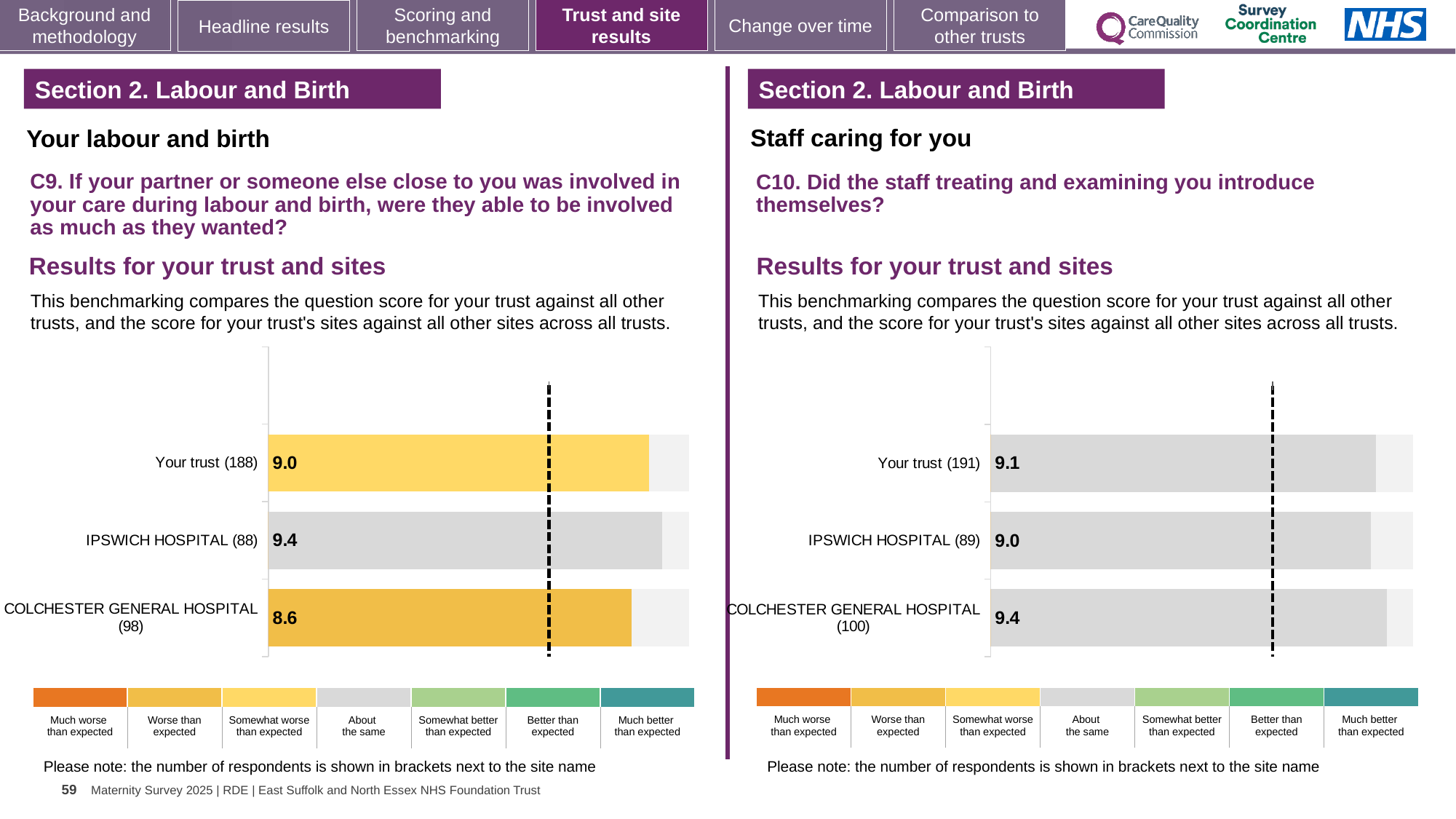
On the C9 chart (left), what is the score for COLCHESTER GENERAL HOSPITAL? 8.6 On the C9 chart (left), which site or trust has the highest score? IPSWICH HOSPITAL On the C10 chart (right), what is the difference between the scores for COLCHESTER GENERAL HOSPITAL and Your trust? 0.3 How many bars are plotted on the C9 chart (left)? 3 What type of chart is used on the C10 chart (right)? Bar chart On the C10 chart (right), which has the larger score, Your trust or COLCHESTER GENERAL HOSPITAL? COLCHESTER GENERAL HOSPITAL On the C10 chart (right), what is the score for COLCHESTER GENERAL HOSPITAL? 9.4 On the C9 chart (left), what is the difference between the scores for IPSWICH HOSPITAL and COLCHESTER GENERAL HOSPITAL? 0.8 On the C9 chart (left), how many respondents are shown in brackets for Your trust? 188 On the C10 chart (right), which site or trust has the lowest score? IPSWICH HOSPITAL On the C9 chart (left), what is the score for Your trust? 9.0 On the C10 chart (right), what is the score for IPSWICH HOSPITAL? 9.0